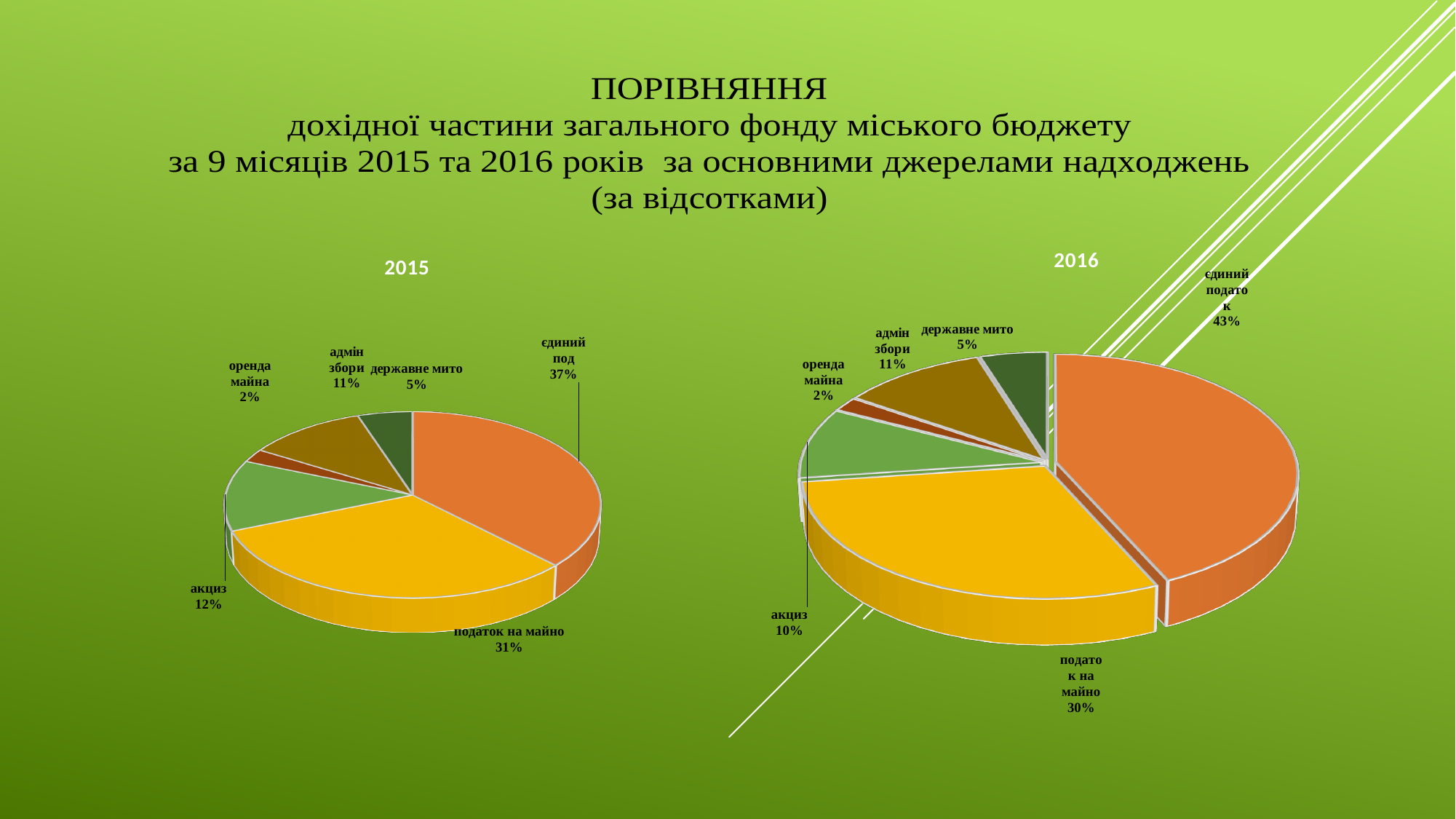
In the 2015 pie chart, which is larger: "акциз" or "адмін збори"? акциз In the 2016 pie chart, what share does "єдиний податок" have? 43% In the 2016 pie chart, which category has the smallest share? оренда майна What is the difference between the share of "єдиний податок" in 2016 and "єдиний под" in 2015? 6% How many categories are shown in the 2015 pie chart? 6 In the 2016 pie chart, what is the difference between "податок на майно" and "акциз"? 20% In the 2015 pie chart, what is the share of "податок на майно"? 31% In the 2015 pie chart, which category has the largest share? єдиний под In the 2015 pie chart, what is the share of "державне мито"? 5% In the 2015 pie chart, what share does "єдиний под" have? 37% What type of chart is used on the slide for 2015 and 2016? Pie chart In the 2016 pie chart, what is the share of "акциз"? 10%